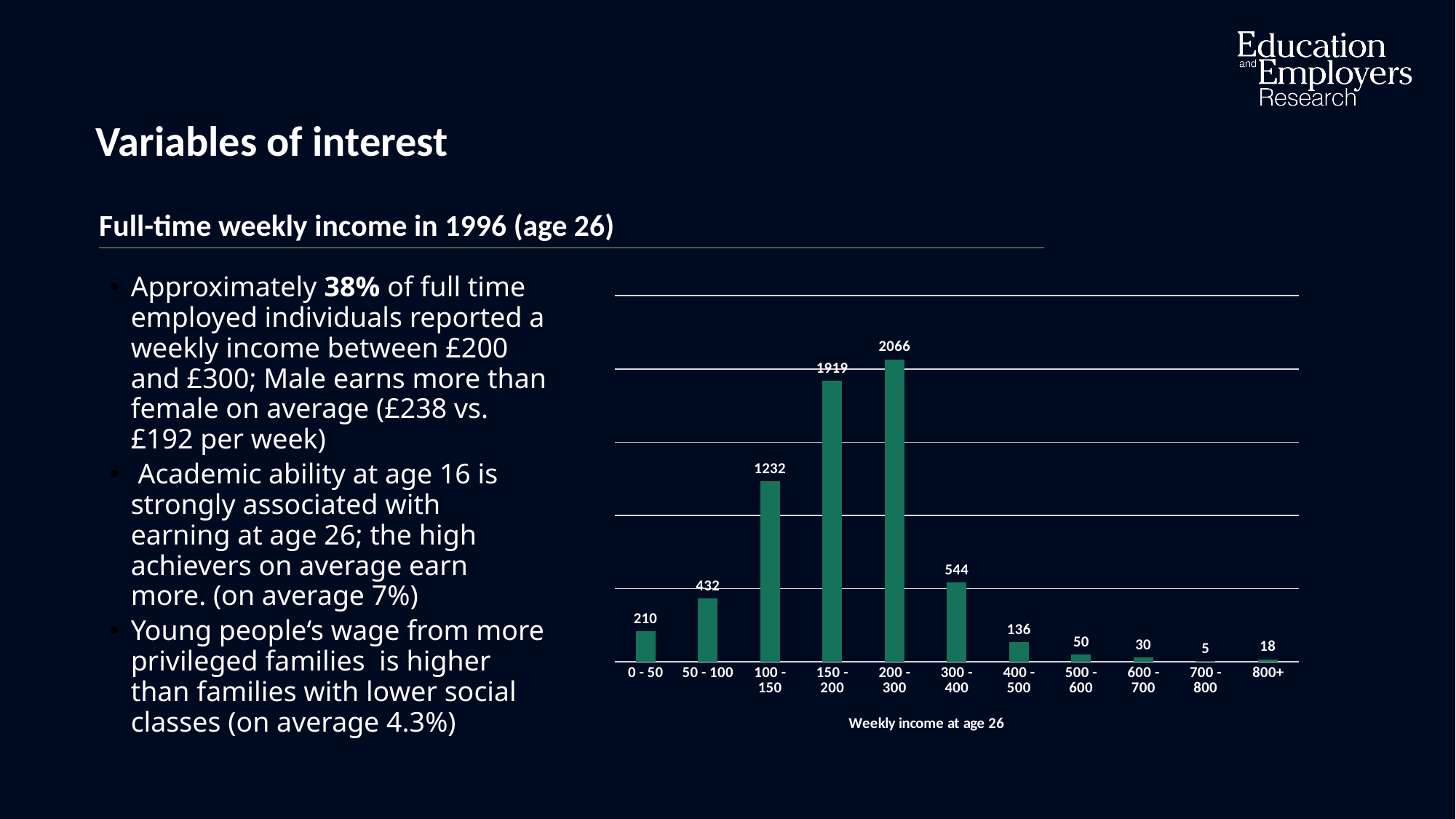
What is the value for the 800+ weekly income category? 18 What is the value for the 0 - 50 weekly income category? 210 How many weekly income categories are shown on the x axis? 11 Which weekly income category has the highest value? 200 - 300 What is the difference between the values for the 200 - 300 and 150 - 200 categories? 147 What is the value for the 300 - 400 weekly income category? 544 What is the value for the 200 - 300 weekly income category? 2066 What kind of chart is shown on the slide? Bar chart What is the x-axis title of the chart? Weekly income at age 26 Which weekly income category has the lowest value? 700 - 800 Which is larger, the value for 300 - 400 or the value for 50 - 100? 300 - 400 What is the difference between the values for the 100 - 150 and 50 - 100 categories? 800